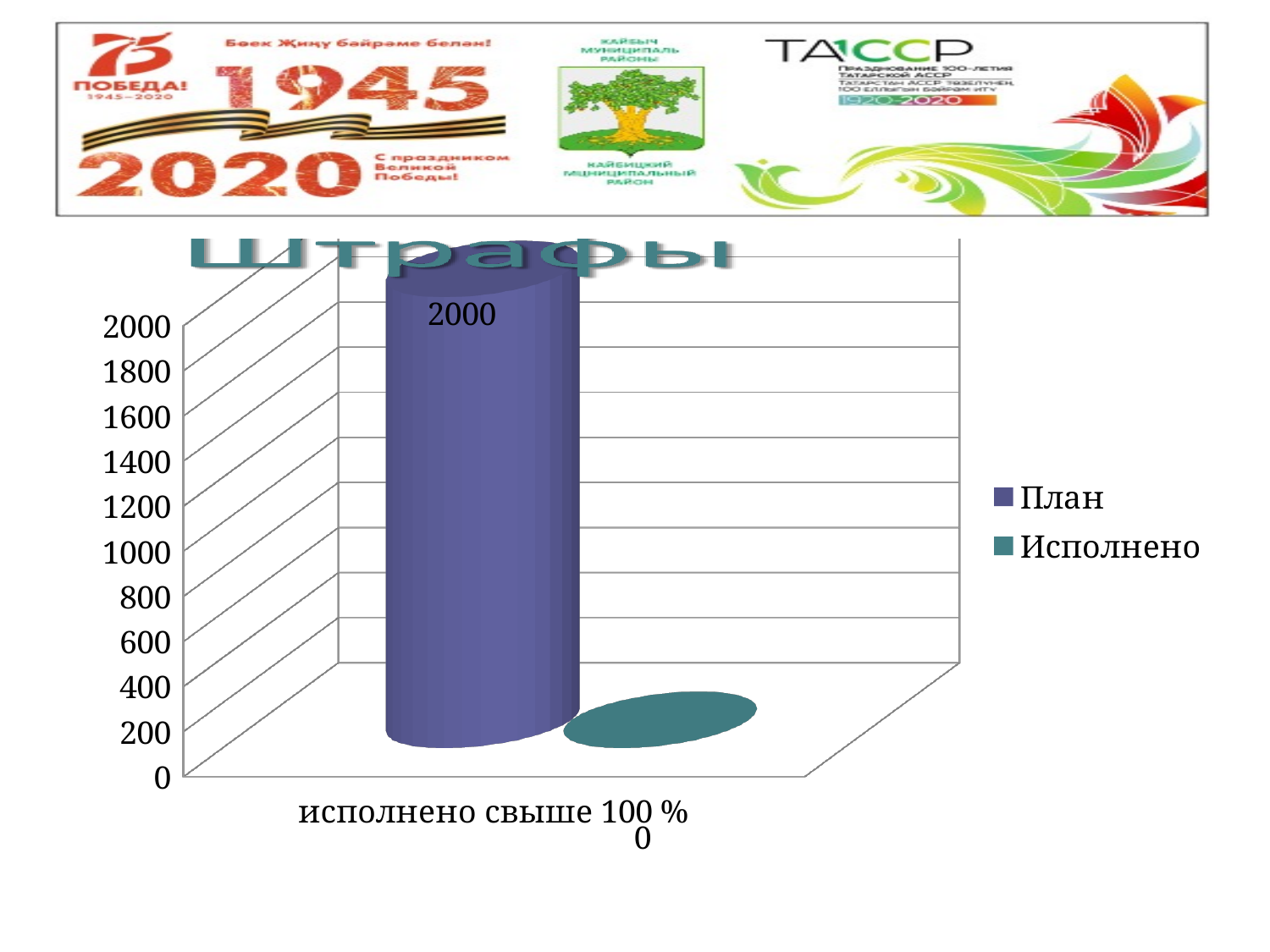
Which series has the higher value, План or Исполнено? План What is the value of the Исполнено series on the chart? 0 Which series has the lowest value on the chart? Исполнено What kind of chart is shown on the slide? bar chart What is the category label shown on the x axis of the chart? исполнено свыше 100 % What is the difference between the План value and the Исполнено value? 2000 Is the value for План greater or less than 1000? greater What is the maximum value shown on the vertical axis of the chart? 2000 What is the title of the chart? Штрафы What is the value of the План series on the chart? 2000 How many series does the legend list? 2